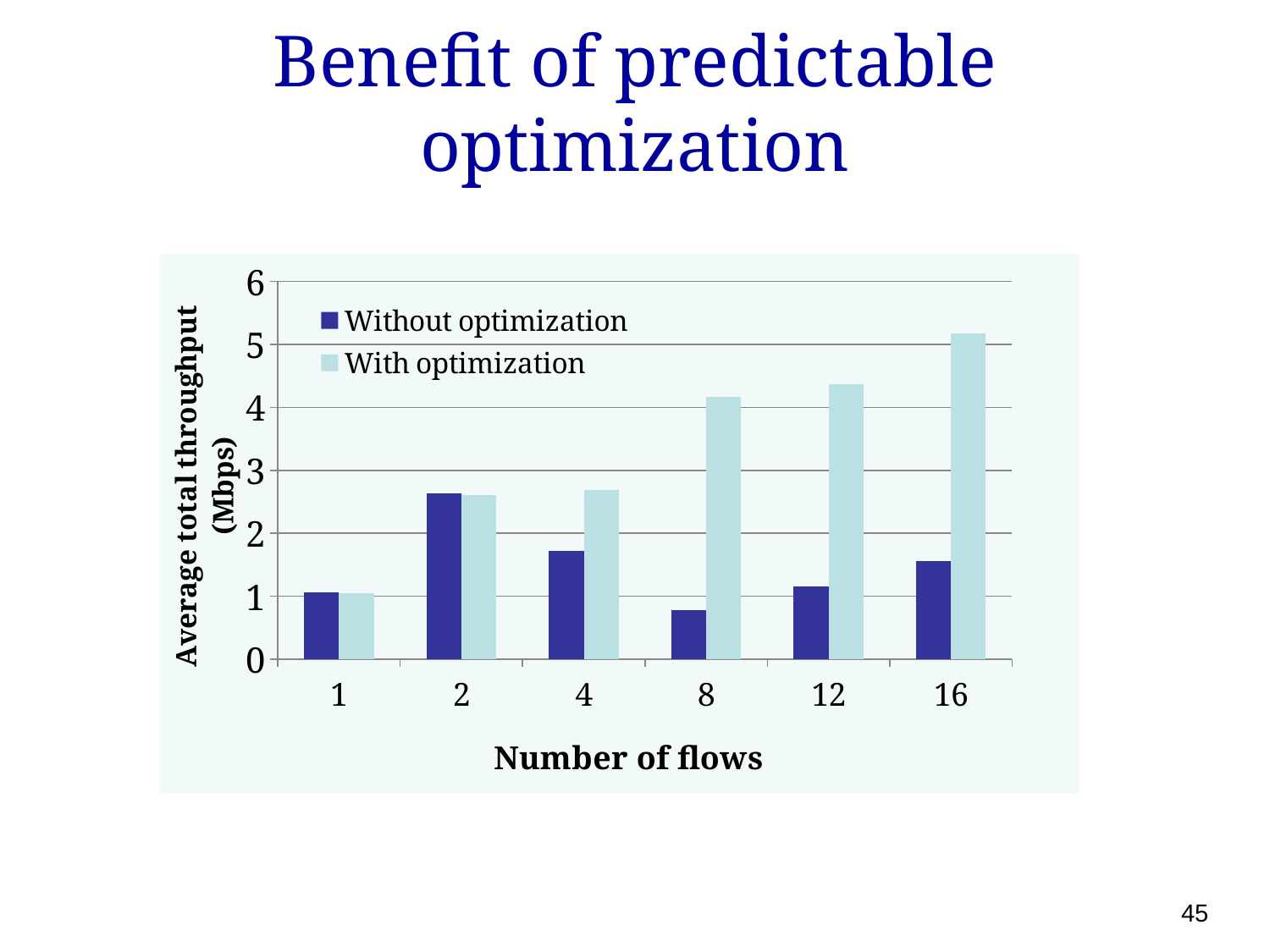
Does the 'With optimization' series rise or fall as the number of flows increases? rise Is the 'Without optimization' value at 8 flows greater or less than 1? less For which number of flows is the 'With optimization' value lowest? 1 For which number of flows is the 'Without optimization' value highest? 2 At 8 flows, which series has the larger value, 'With optimization' or 'Without optimization'? With optimization Is the 'With optimization' value at 16 flows greater or less than 5? greater For which number of flows is the 'Without optimization' value lowest? 8 For which number of flows is the 'With optimization' value highest? 16 How many series does the legend list? 2 What is the label of the y axis? Average total throughput (Mbps) What kind of chart is shown on the slide? bar chart How many categories (numbers of flows) are shown on the x axis? 6